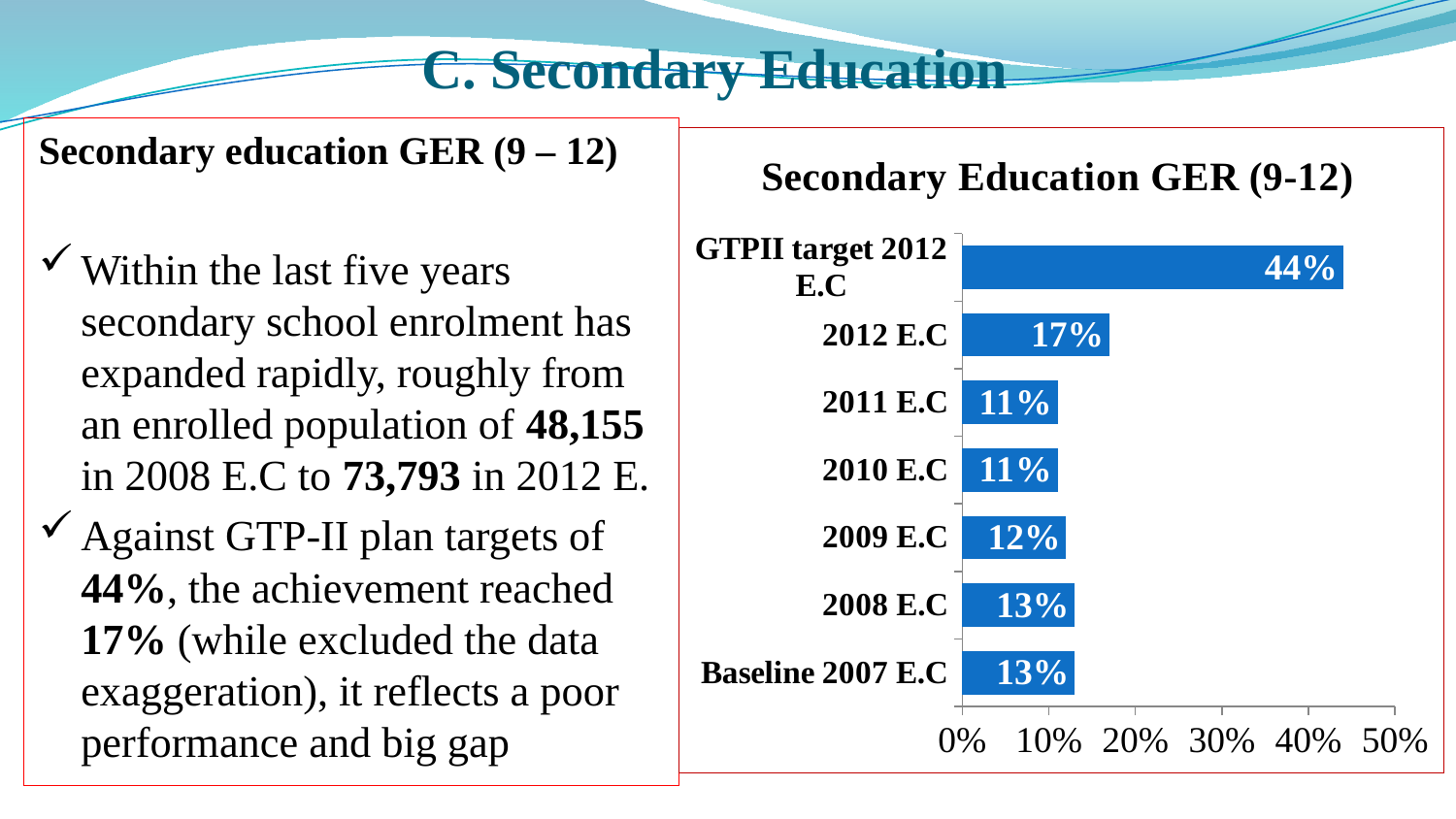
What is the value for 2009 E.C? 12% Is the value for GTPII target 2012 E.C greater or less than 40%? greater What is the title of the chart? Secondary Education GER (9-12) Which category has the highest value in the chart? GTPII target 2012 E.C How many categories (bars) are shown in the chart? 7 What kind of chart is shown on the slide? bar chart What is the value for GTPII target 2012 E.C? 44% What is the difference between the 2008 E.C value and the 2009 E.C value? 1% What is the value for Baseline 2007 E.C? 13% Which is larger, the value for 2012 E.C or the value for 2011 E.C? 2012 E.C What is the value for 2012 E.C in the Secondary Education GER (9-12) chart? 17% What is the difference between the GTPII target 2012 E.C value and the 2012 E.C value? 27%